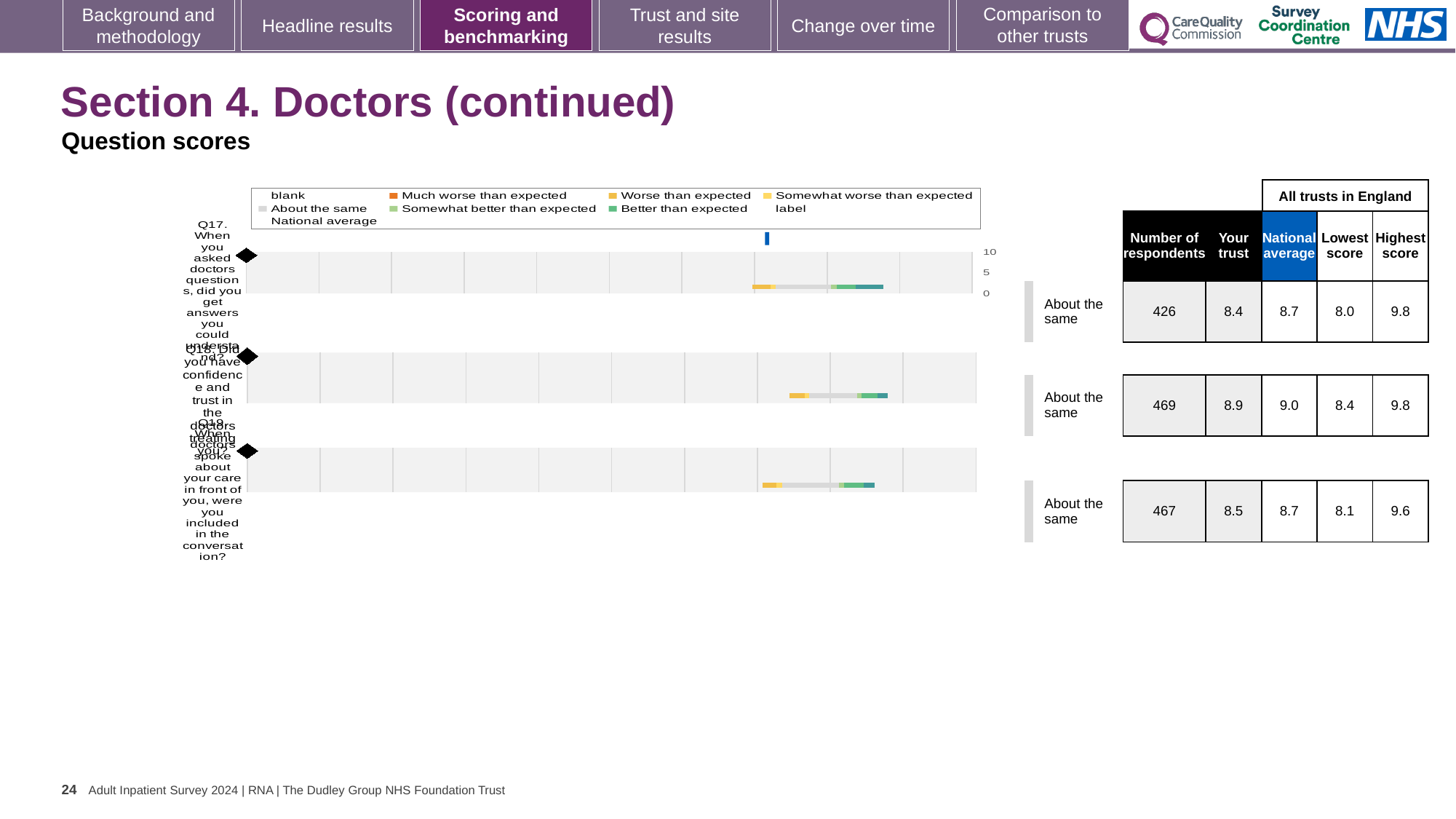
What is the difference between the national average and the 'Your trust' score for Q17? 0.3 What is the highest score across all trusts in England for Q19? 9.6 Which of the three questions has the lowest number of respondents? Q17 What is the national average for Q18 (Did you have confidence and trust in the doctors treating you)? 9.0 What kind of chart is used to show the question scores? bar chart How many questions (rows) are plotted in the chart? 3 What benchmark category is shown for Q18? About the same Is the 'Your trust' score for Q18 larger or smaller than the 'Your trust' score for Q19? larger What is the number of respondents for Q19 (When doctors spoke about your care in front of you, were you included in the conversation)? 467 Which of the three questions has the highest 'Your trust' score? Q18 What is the lowest score across all trusts in England for Q17? 8.0 What is the 'Your trust' score for Q17 (When you asked doctors questions, did you get answers you could understand)? 8.4